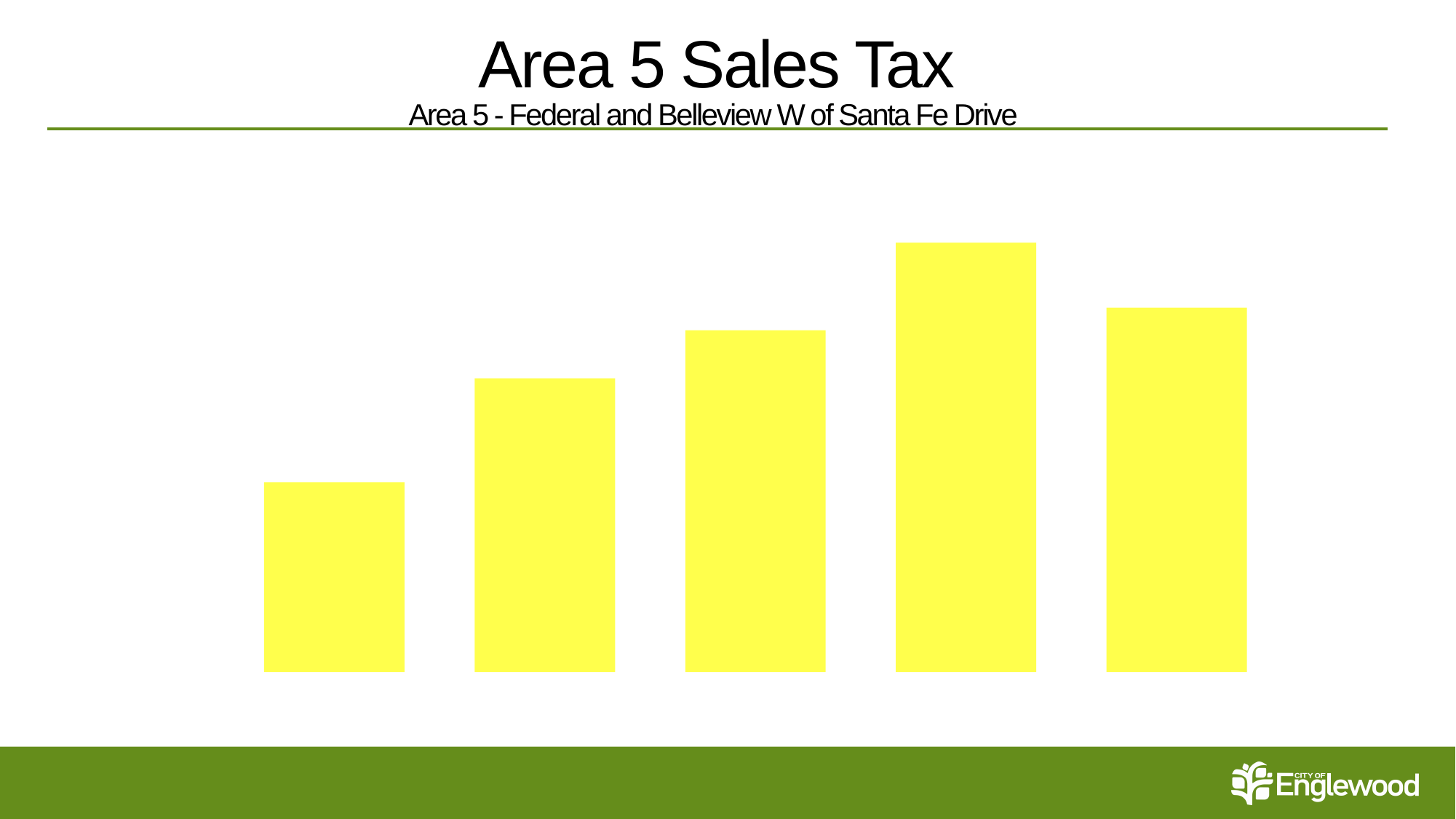
What is the title of the slide containing the chart? Area 5 Sales Tax What colour are the bars in the chart? yellow Do the bars rise or fall from the first bar to the fourth bar? rise Do the bars rise or fall from the fourth bar to the fifth bar? fall Which bar is the tallest in the chart, counting from the left? the fourth bar How many bars does the chart show? 5 Which bar is the shortest in the chart, counting from the left? the first bar Which is taller, the first bar from the left or the fifth bar from the left? the fifth bar What kind of chart is shown on the slide? bar chart Which is taller, the fourth bar from the left or the fifth bar from the left? the fourth bar Which is taller, the second bar from the left or the third bar from the left? the third bar